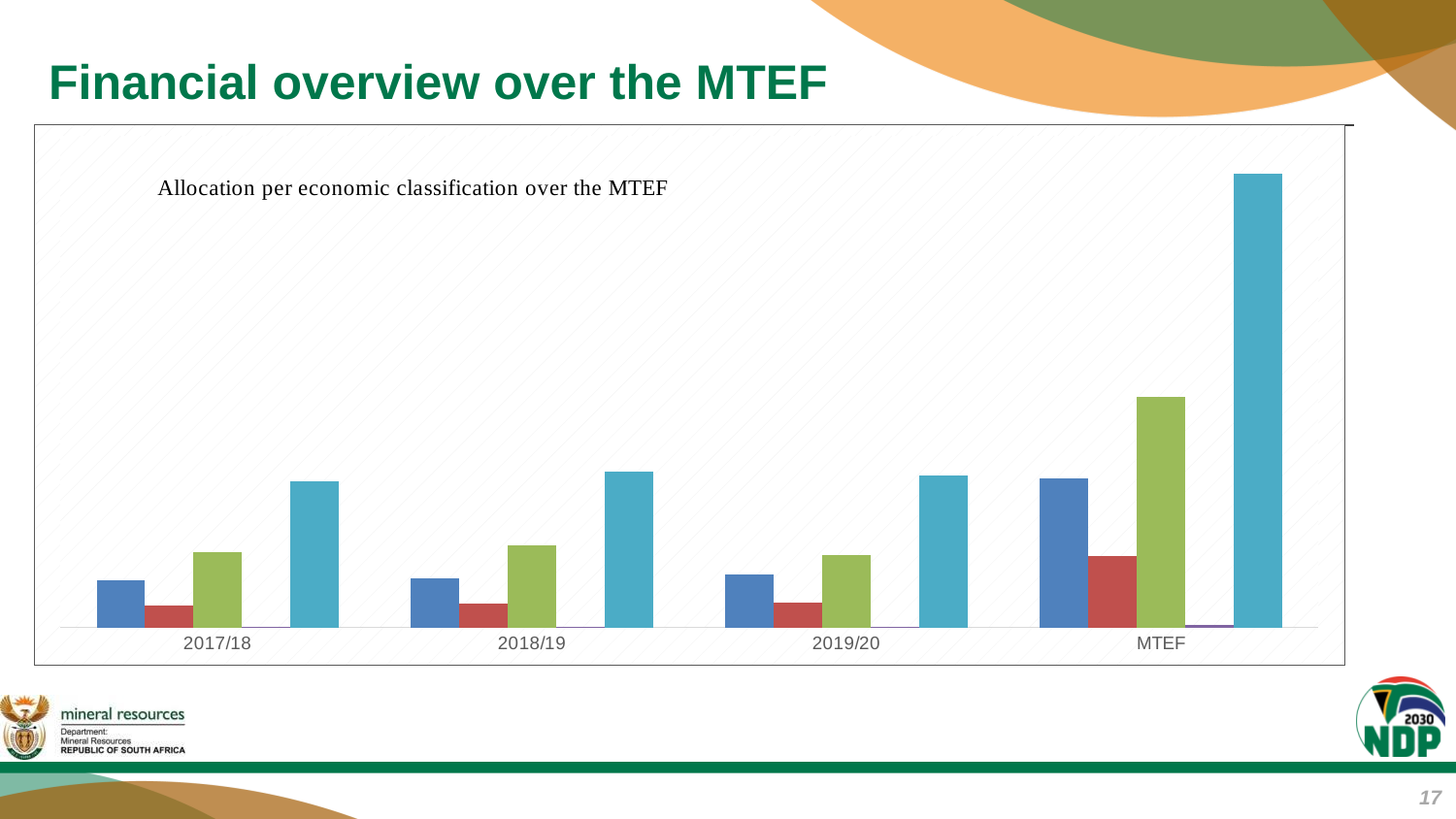
What kind of chart is shown on the slide? Bar chart What is the label of the last category on the x axis? MTEF Does the chart display a legend identifying the series? No Which category on the x axis has the tallest bar in the chart? MTEF How many categories are shown along the x axis of the chart? 4 What is the title of the chart? Allocation per economic classification over the MTEF